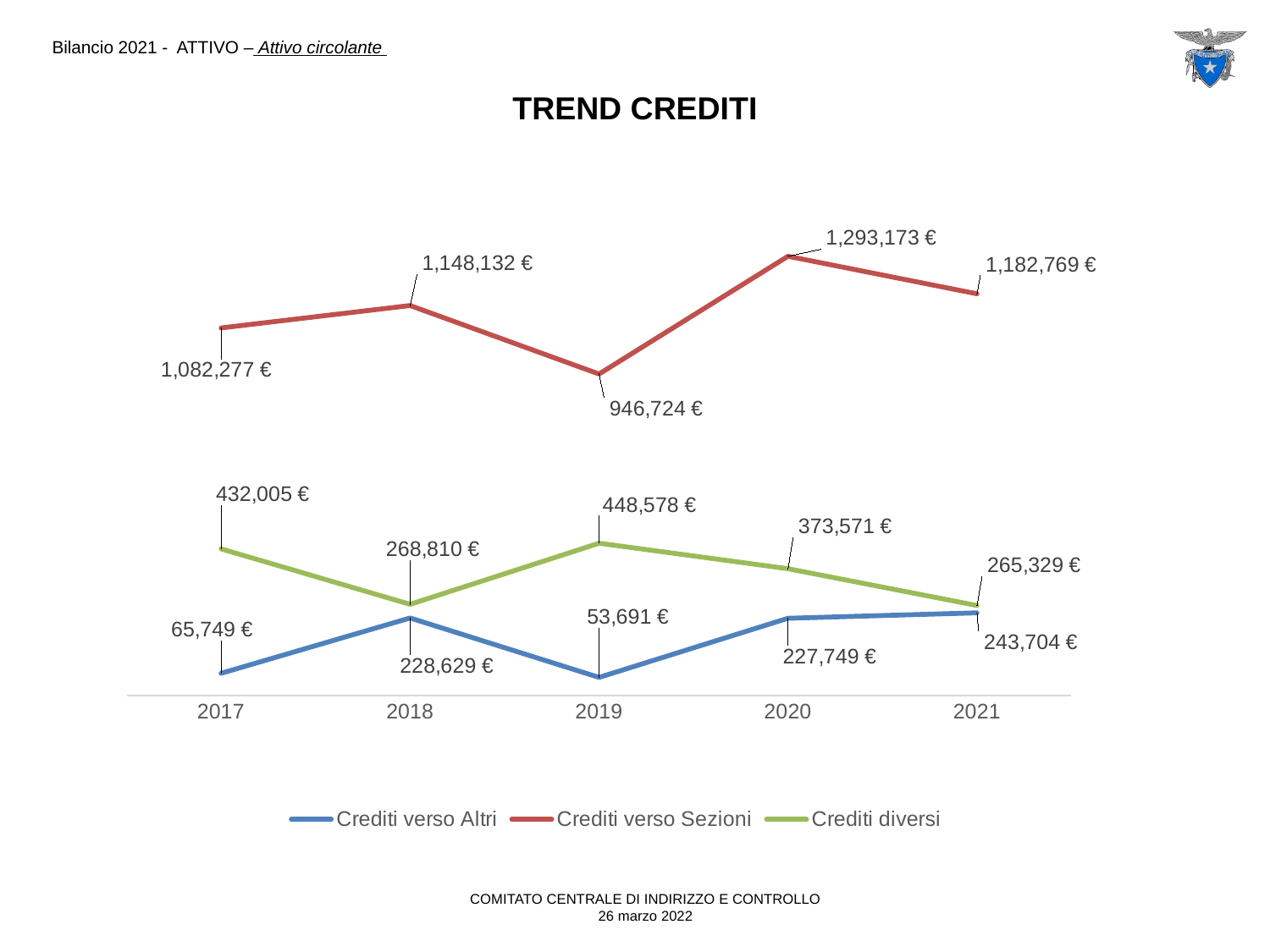
How many series does the legend list? 3 What is the title of the chart? TREND CREDITI What kind of chart is shown? Line chart What is the value of Crediti diversi in 2019? 448,578 € Which is larger in 2018: Crediti diversi or Crediti verso Altri? Crediti diversi In which year is Crediti verso Altri at its highest? 2021 What is the value of Crediti verso Altri in 2017? 65,749 € Does Crediti diversi rise or fall from 2019 to 2021? Fall How many years are shown on the x axis? 5 In which year is Crediti verso Sezioni at its lowest? 2019 What is the difference between Crediti verso Sezioni in 2020 and in 2021? 110,404 € What is the value of Crediti verso Sezioni in 2020? 1,293,173 €